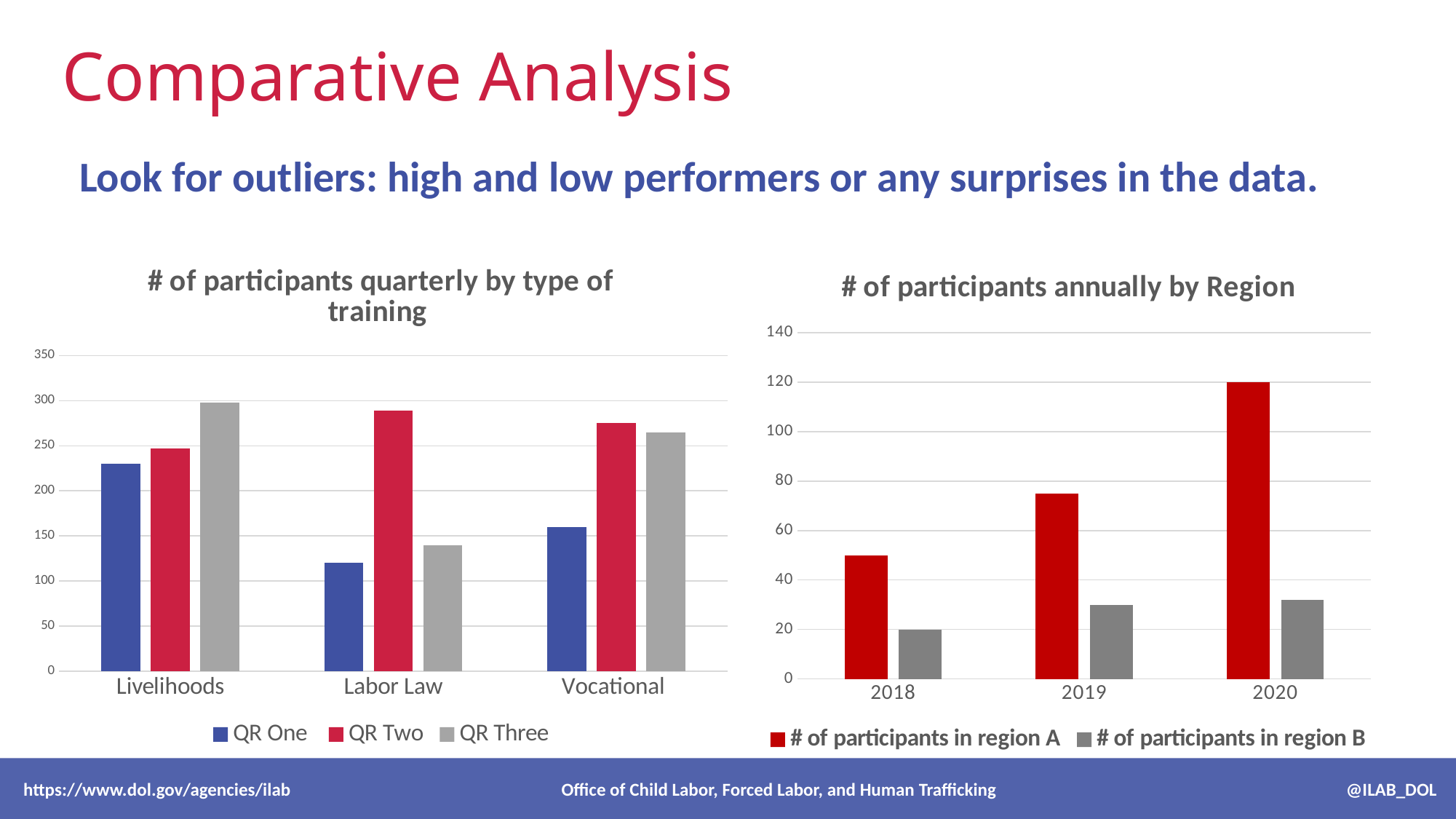
In the '# of participants quarterly by type of training' chart, for Labor Law, which is larger: QR Two or QR Three? QR Two In the '# of participants quarterly by type of training' chart, how many types of training are shown on the x axis? 3 In the '# of participants quarterly by type of training' chart, how many series does the legend list? 3 In the '# of participants annually by Region' chart, what is the number of participants in region B in 2018? 20 In the '# of participants quarterly by type of training' chart, which type of training has the lowest QR One value? Labor Law What kind of chart is the '# of participants quarterly by type of training' chart? bar chart In the '# of participants annually by Region' chart, is the value for region A in 2019 greater or less than 60? greater In the '# of participants quarterly by type of training' chart, is the QR Two value for Labor Law greater or less than 250? greater In the '# of participants annually by Region' chart, what is the number of participants in region A in 2020? 120 In the '# of participants annually by Region' chart, do the values for region A rise or fall from 2018 to 2020? rise In the '# of participants annually by Region' chart, how many series does the legend list? 2 In the '# of participants quarterly by type of training' chart, which type of training has the highest QR Three value? Livelihoods